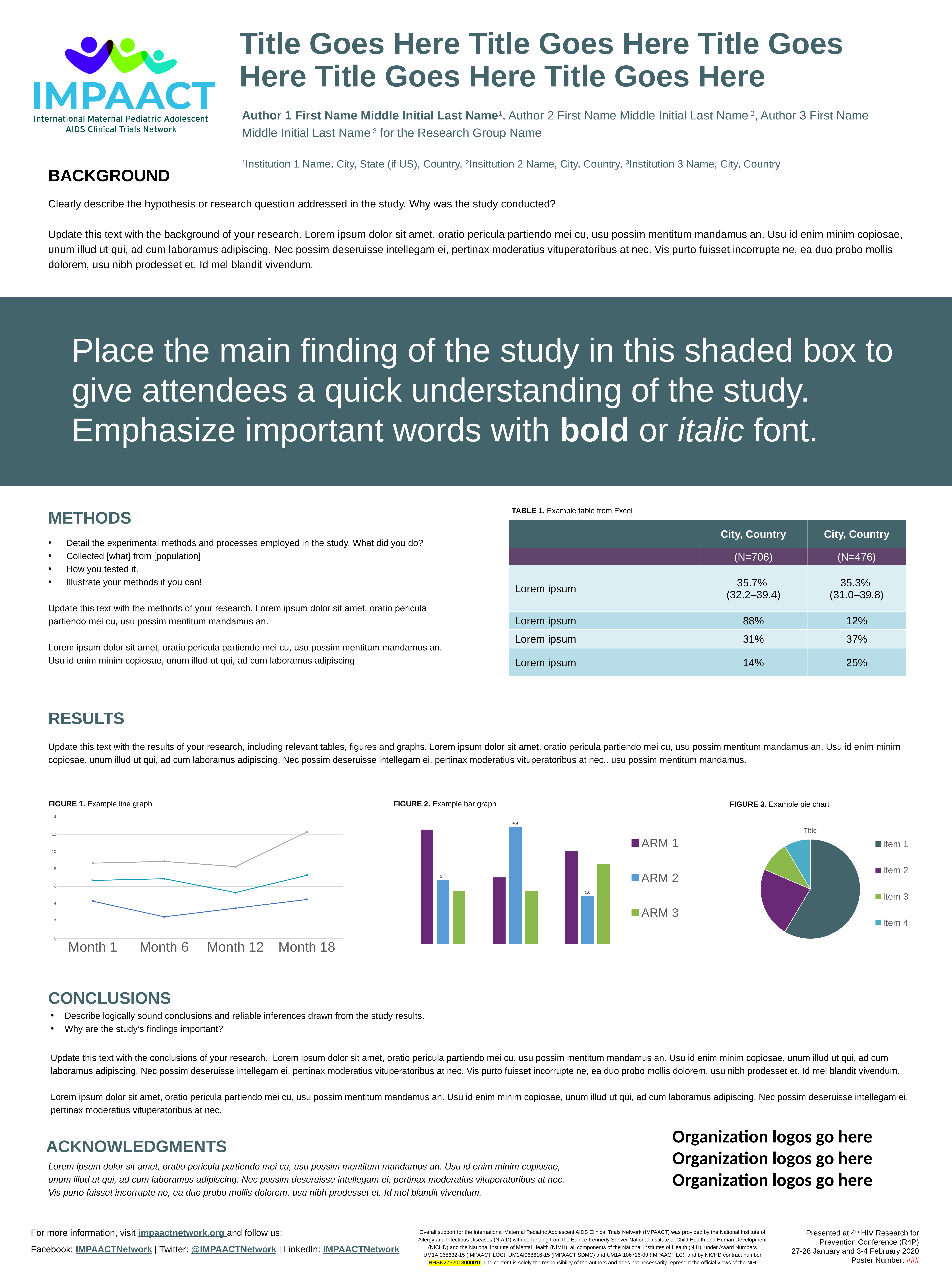
In Figure 2, what is the difference between the ARM 2 values in the middle group (4.4) and the rightmost group (1.8)? 2.6 In Figure 2, how many series does the legend list? 3 In Figure 1, how many categories are shown on the x axis? 4 In Figure 3, the example pie chart, which item has the largest slice? Item 1 In Figure 2, in the leftmost group of bars, which is larger: ARM 1 or ARM 2? ARM 1 In Figure 2, what is the labelled value of the ARM 2 bar in the first (leftmost) group of bars? 2.4 In Figure 3, the example pie chart, how many items does the legend list? 4 What kind of chart is Figure 2, the example bar graph? bar chart In Figure 1, is the value of the gray line at Month 18 greater or less than 10? greater What kind of chart is Figure 1, the example line graph? line chart In Figure 1, does the gray line rise or fall between Month 12 and Month 18? rise In Figure 2, what is the labelled value of the ARM 2 bar in the middle group of bars? 4.4